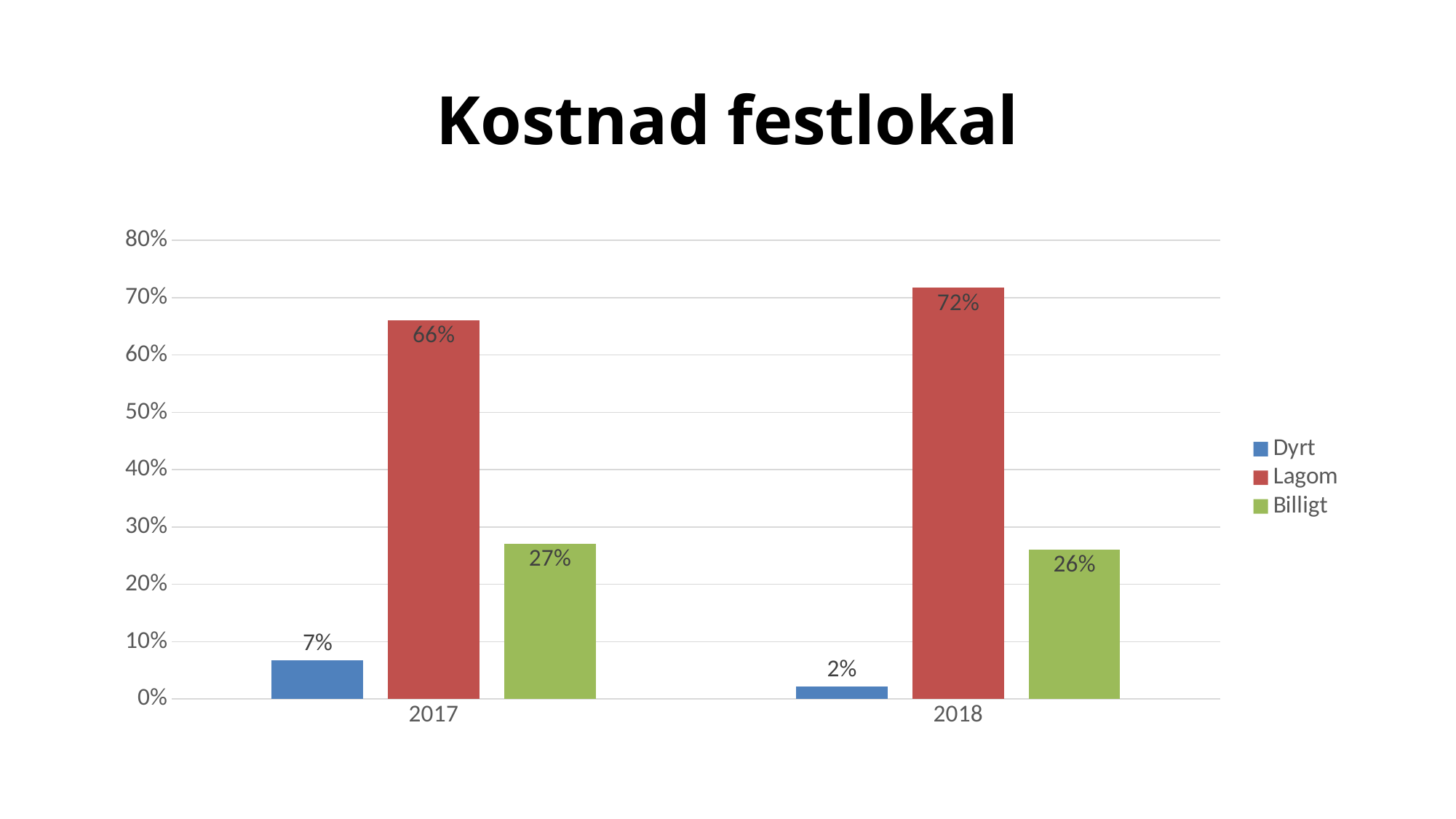
What is the value for Lagom in 2017? 66% What is the difference between the Lagom values for 2018 and 2017? 6% What is the title of the chart? Kostnad festlokal How many series does the legend list? 3 Which series has the lowest value in 2017? Dyrt What is the value for Dyrt in 2018? 2% Is the value for Lagom in 2018 greater or less than 70%? greater Which is larger, Billigt in 2017 or Billigt in 2018? Billigt in 2017 How many years are shown on the x axis? 2 Which series has the highest value in 2018? Lagom What is the value for Billigt in 2017? 27% What kind of chart is shown? Bar chart